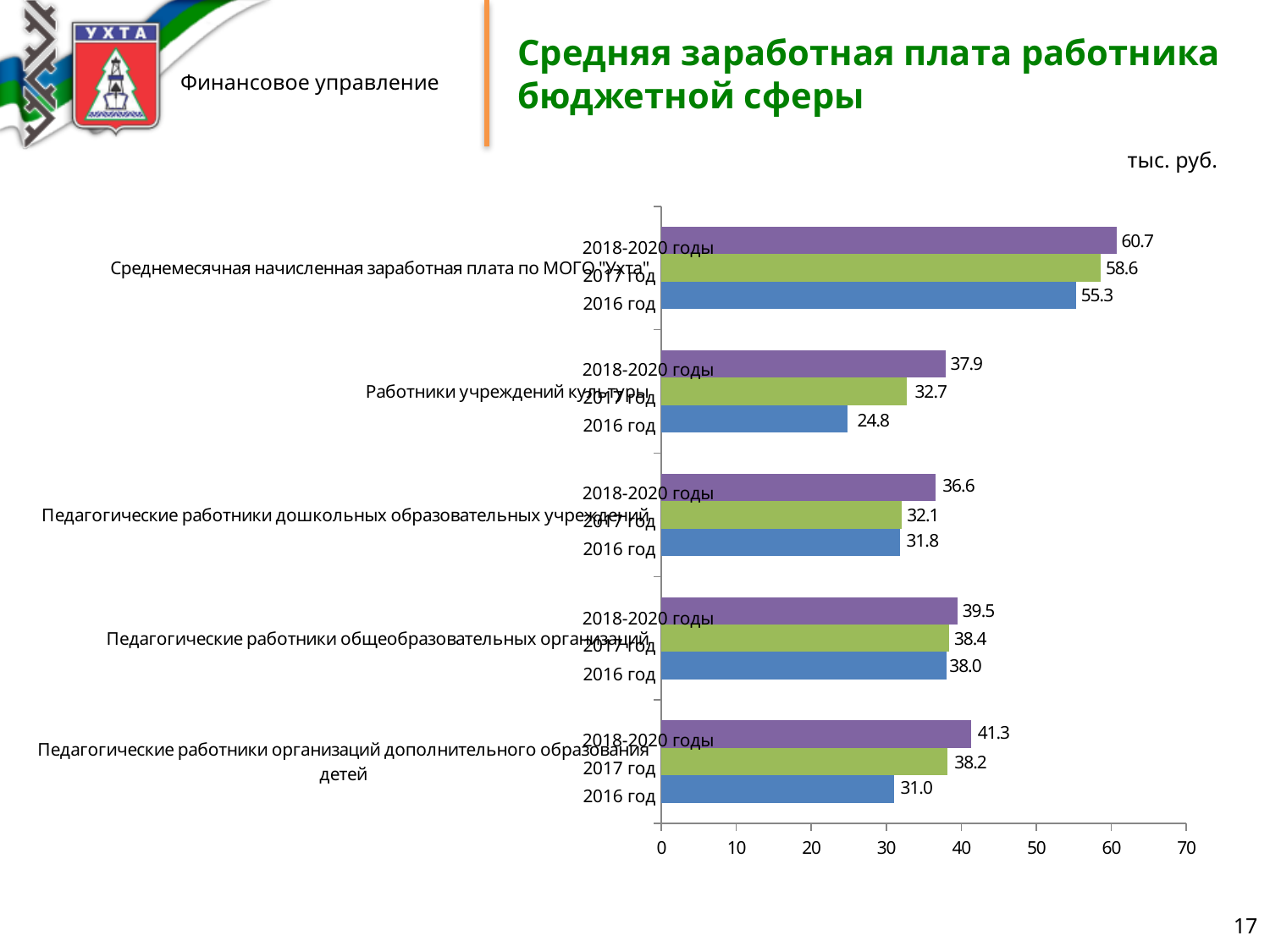
Is the value for 2016 год for Среднемесячная начисленная заработная плата по МОГО "Ухта" greater or less than 50? greater What unit is indicated for the values on the chart? тыс. руб. What is the value for 2018-2020 годы for Работники учреждений культуры? 37.9 Which category has the highest value for 2018-2020 годы? Среднемесячная начисленная заработная плата по МОГО "Ухта" Which is larger for 2017 год: Педагогические работники общеобразовательных организаций or Педагогические работники дошкольных образовательных учреждений? Педагогические работники общеобразовательных организаций What is the value for 2017 год for Среднемесячная начисленная заработная плата по МОГО "Ухта"? 58.6 What kind of chart is shown on the slide? Bar chart Which category has the lowest value for 2016 год? Работники учреждений культуры For Педагогические работники организаций дополнительного образования детей, do the values rise or fall from 2016 год to 2018-2020 годы? Rise How many categories (groups of bars) are shown on the chart? 5 What is the value for 2016 год for Педагогические работники организаций дополнительного образования детей? 31.0 What is the difference between the 2018-2020 годы and 2016 год values for Работники учреждений культуры? 13.1